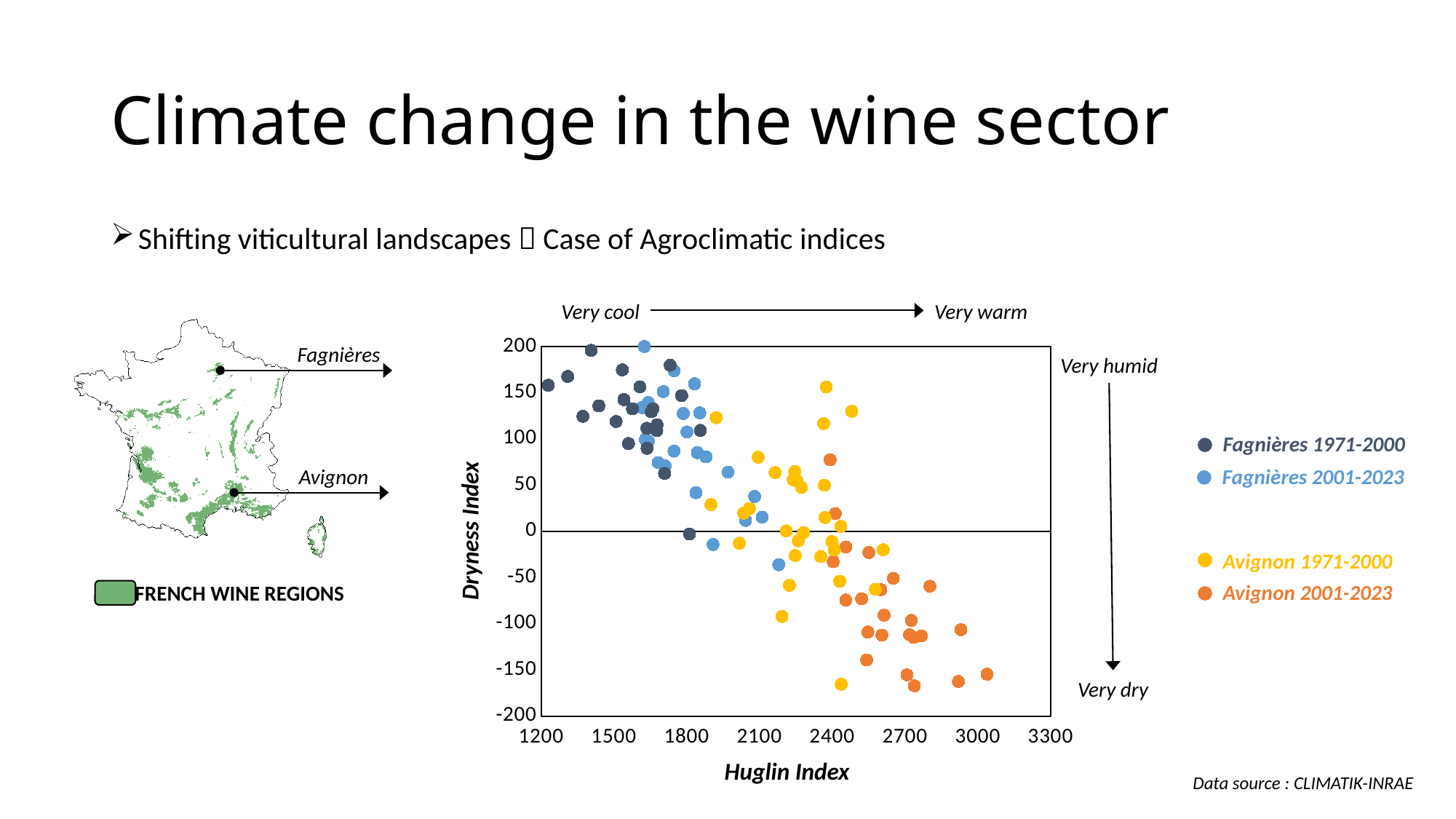
As the Huglin Index increases along the x axis, does the Dryness Index generally rise or fall? Fall Which series has the points with the highest Huglin Index values, Fagnières 1971-2000 or Avignon 2001-2023? Avignon 2001-2023 What is the label of the horizontal axis of the chart? Huglin Index What is the highest tick value shown on the Huglin Index axis? 3300 Are the Avignon 2001-2023 points at Huglin Index values greater or less than 2100? greater What is the label of the vertical axis of the chart? Dryness Index Which series has the points with the lowest Huglin Index values overall? Fagnières 1971-2000 What kind of chart is shown on the slide? Scatter chart Are the Fagnières 1971-2000 points at Huglin Index values greater or less than 2100? less Which series has the points with the highest Huglin Index values overall? Avignon 2001-2023 How many series does the chart legend list? 4